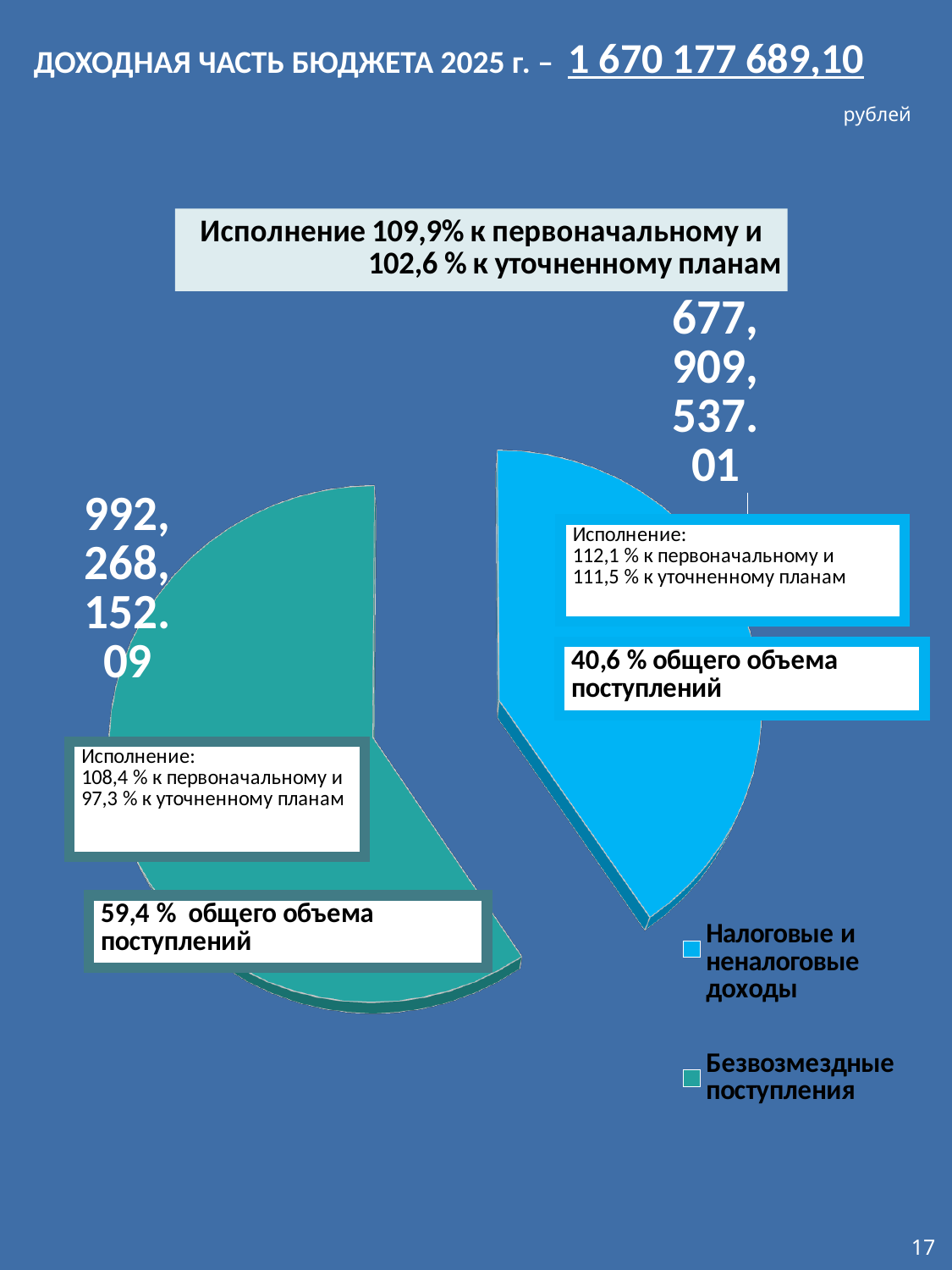
What is the value shown for Налоговые и неналоговые доходы? 677,909,537.01 What share of total receipts do Безвозмездные поступления make up? 59,4 % Which category has the largest slice of the pie? Безвозмездные поступления Which is larger: Налоговые и неналоговые доходы or Безвозмездные поступления? Безвозмездные поступления How many slices does the pie chart have? 2 What share of total receipts do Налоговые и неналоговые доходы make up? 40,6 % Which category has the smallest slice of the pie? Налоговые и неналоговые доходы How many entries does the legend list? 2 What is the difference between the value for Безвозмездные поступления and the value for Налоговые и неналоговые доходы? 314,358,615.08 What kind of chart is shown on the slide? pie chart Which colour represents Налоговые и неналоговые доходы in the pie chart? blue What is the value shown for Безвозмездные поступления? 992,268,152.09